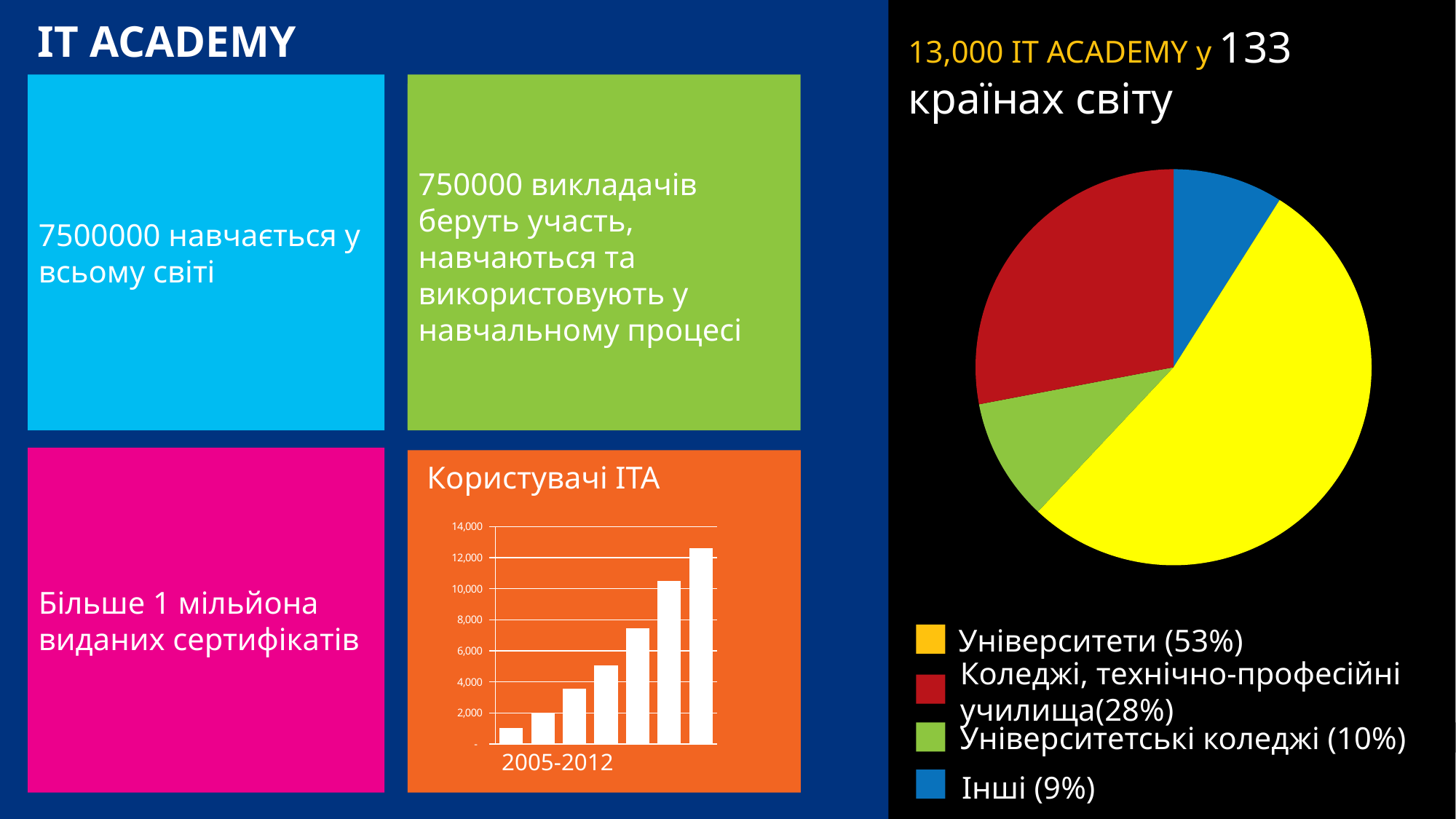
In the chart titled "Користувачі ITA", do the values rise or fall from left to right across 2005-2012? rise In the pie chart on the right, what share does Університети have? 53% How many categories does the legend of the pie chart on the right list? 4 What kind of chart is shown on the right side of the slide under "13,000 IT ACADEMY у 133 країнах світу"? pie chart In the chart titled "Користувачі ITA", what is the highest value shown on the vertical axis? 14,000 In the chart titled "Користувачі ITA", is the value of the leftmost bar greater or less than 2,000? less In the pie chart on the right, what share does Інші have? 9% In the pie chart on the right, which category has the smallest share? Інші In the pie chart on the right, which category has the largest share? Університети In the chart titled "Користувачі ITA", is the value of the rightmost bar greater or less than 12,000? greater What kind of chart is the chart titled "Користувачі ITA"? bar chart In the pie chart on the right, how many percentage points larger is the share of Університети than the share of Коледжі, технічно-професійні училища? 25